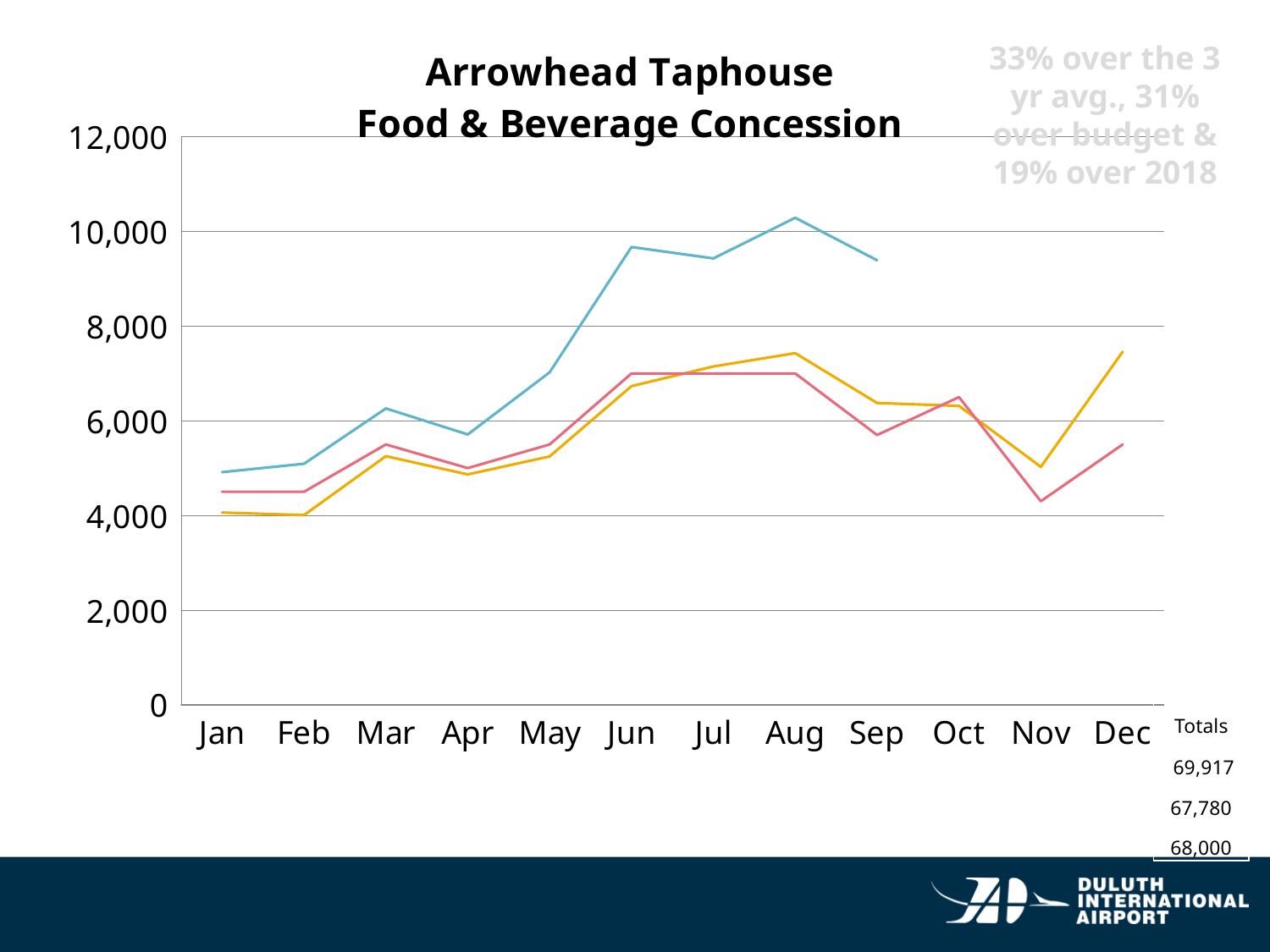
How many months are shown on the x axis of the chart? 12 What kind of chart is shown on the slide? line chart In Dec, which line has the higher value, the yellow line or the pink line? yellow line Is the value of the blue line in Jan greater or less than 6,000? less In which month does the blue line reach its highest value? Aug Is the value of the yellow line in Dec greater or less than 6,000? greater Is the value of the pink line in Nov greater or less than 6,000? less What is the last month for which the blue line has a plotted value? Sep In Jun, which line has the higher value, the blue line or the pink line? blue line Does the blue line generally rise or fall from Jan to Jun? rise What is the title of the chart? Arrowhead Taphouse Food & Beverage Concession